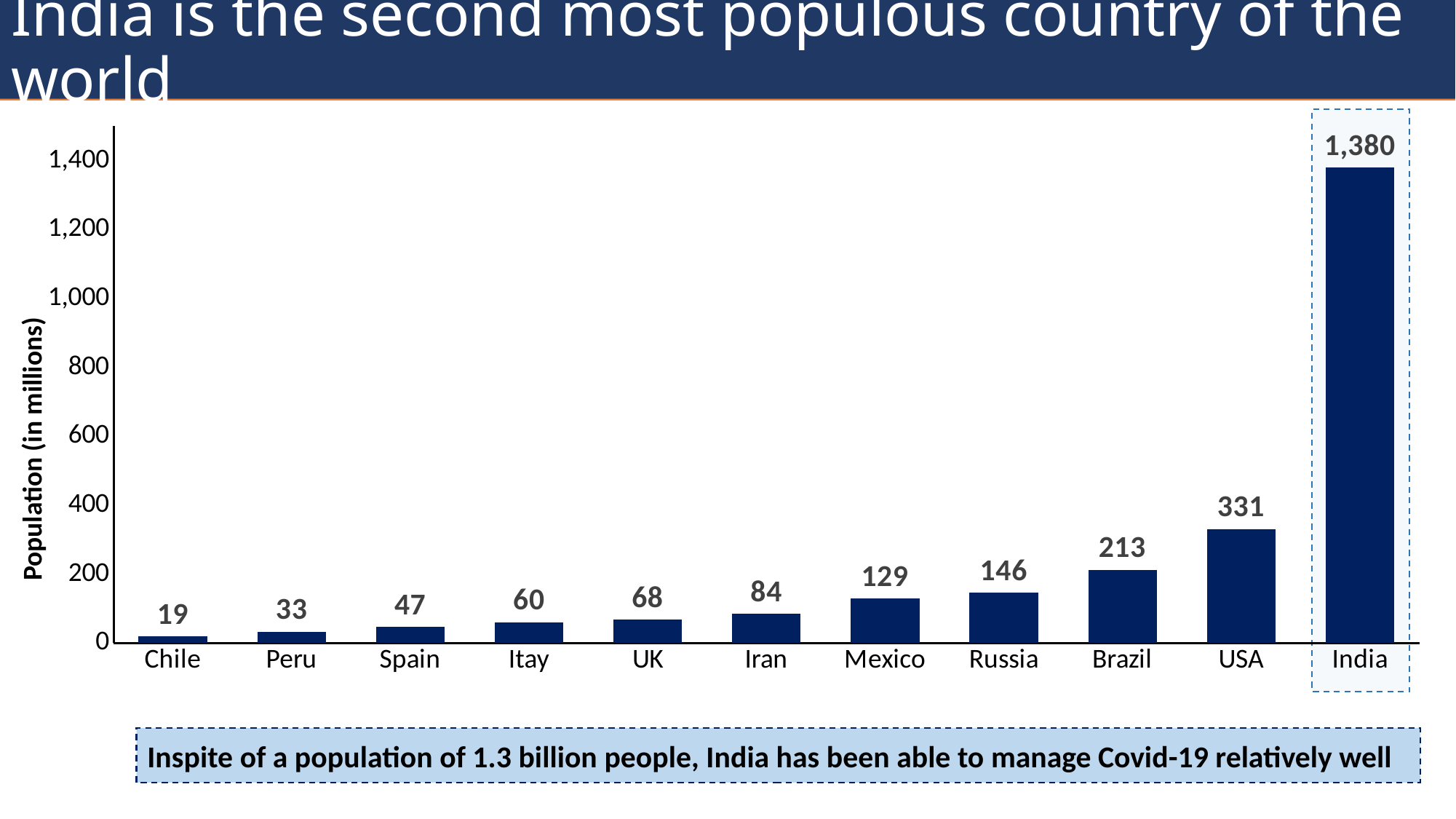
What is the population (in millions) shown for Brazil? 213 What is the difference in population (in millions) between the USA and Brazil? 118 What is the difference in population (in millions) between India and the USA? 1,049 What is the label of the vertical axis? Population (in millions) Which country has the lowest population in the chart? Chile What is the population (in millions) shown for India? 1,380 Which country has the highest population in the chart? India How many countries are shown in the chart? 11 What is the population (in millions) shown for Mexico? 129 Is the value for the USA greater or less than 400? less Which has a larger population, Russia or Iran? Russia What kind of chart is shown on the slide? Bar chart